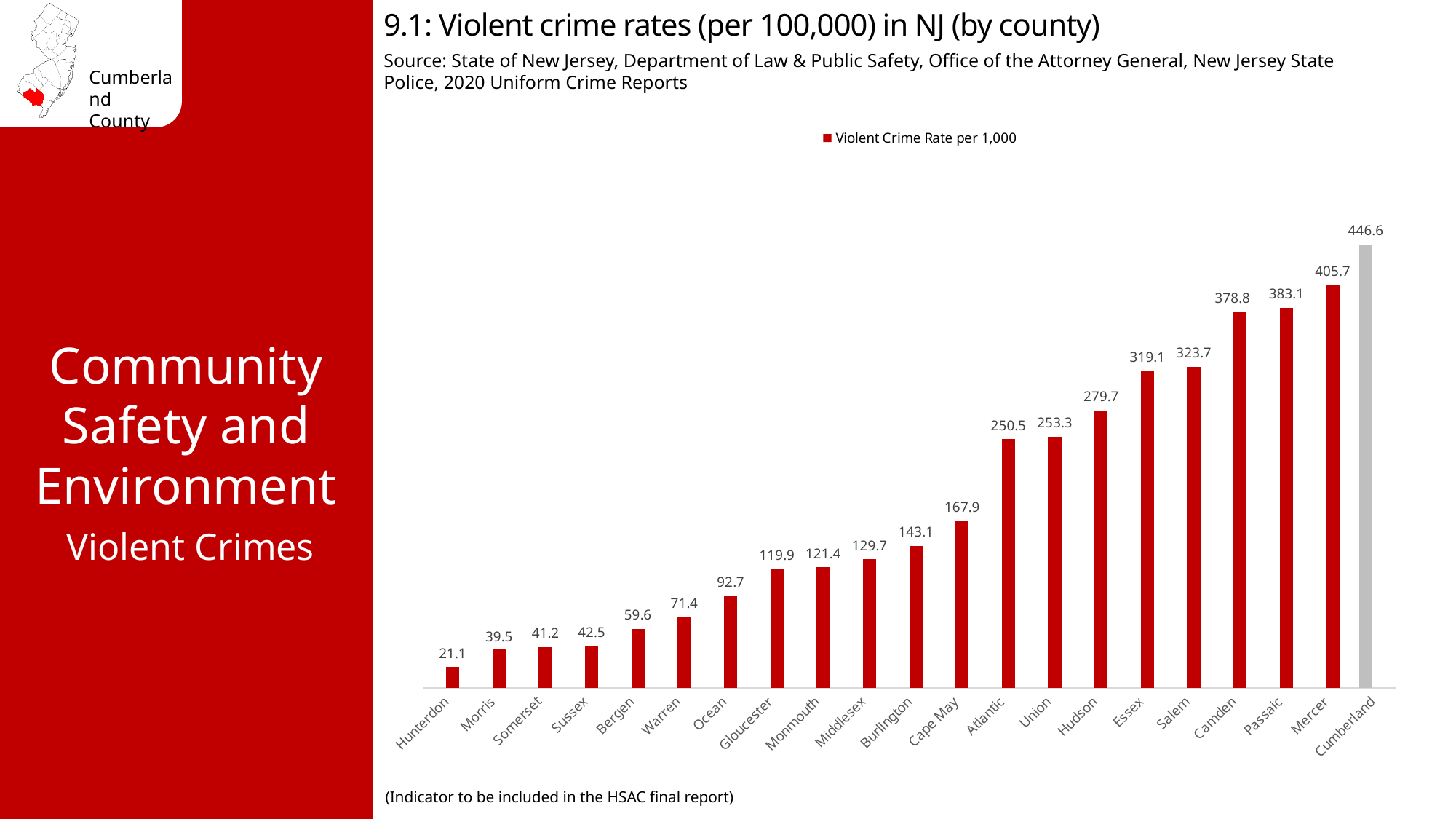
What kind of chart is shown on the slide? Bar chart Which county has the highest violent crime rate on the chart? Cumberland How many series does the legend list? 1 Which county has the lowest violent crime rate on the chart? Hunterdon Do the values rise or fall moving from left to right along the x axis? Rise Which county has a higher violent crime rate, Essex or Camden? Camden What is the violent crime rate shown for Cumberland? 446.6 What is the difference between the violent crime rates of Cumberland and Hunterdon? 425.5 What is the violent crime rate shown for Hudson? 279.7 How many counties are shown on the chart? 21 What is the violent crime rate shown for Ocean? 92.7 What is the difference between the violent crime rates of Cumberland and Mercer? 40.9